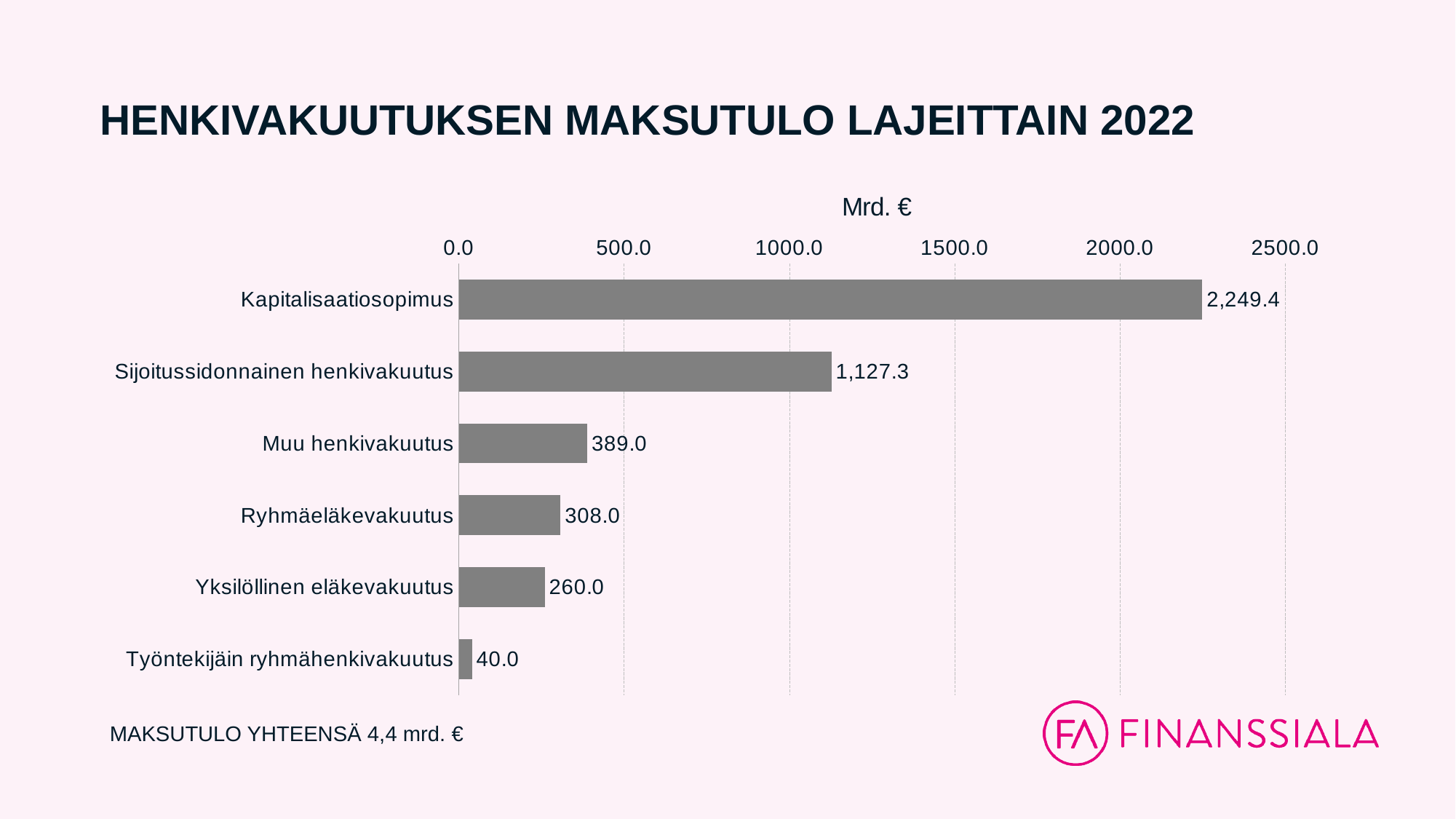
What is the value for Muu henkivakuutus? 389.0 What is the value for Kapitalisaatiosopimus? 2,249.4 What is the difference between the values for Muu henkivakuutus and Ryhmäeläkevakuutus? 81.0 What unit is shown on the axis label of the chart? Mrd. € What is the difference between the values for Kapitalisaatiosopimus and Sijoitussidonnainen henkivakuutus? 1,122.1 What is the value for Työntekijäin ryhmähenkivakuutus? 40.0 What kind of chart is shown on the slide? Bar chart Which category has the lowest value? Työntekijäin ryhmähenkivakuutus What is the value for Sijoitussidonnainen henkivakuutus? 1,127.3 How many categories are shown in the chart? 6 Which category has the highest value? Kapitalisaatiosopimus Which is larger, the value for Ryhmäeläkevakuutus or the value for Yksilöllinen eläkevakuutus? Ryhmäeläkevakuutus